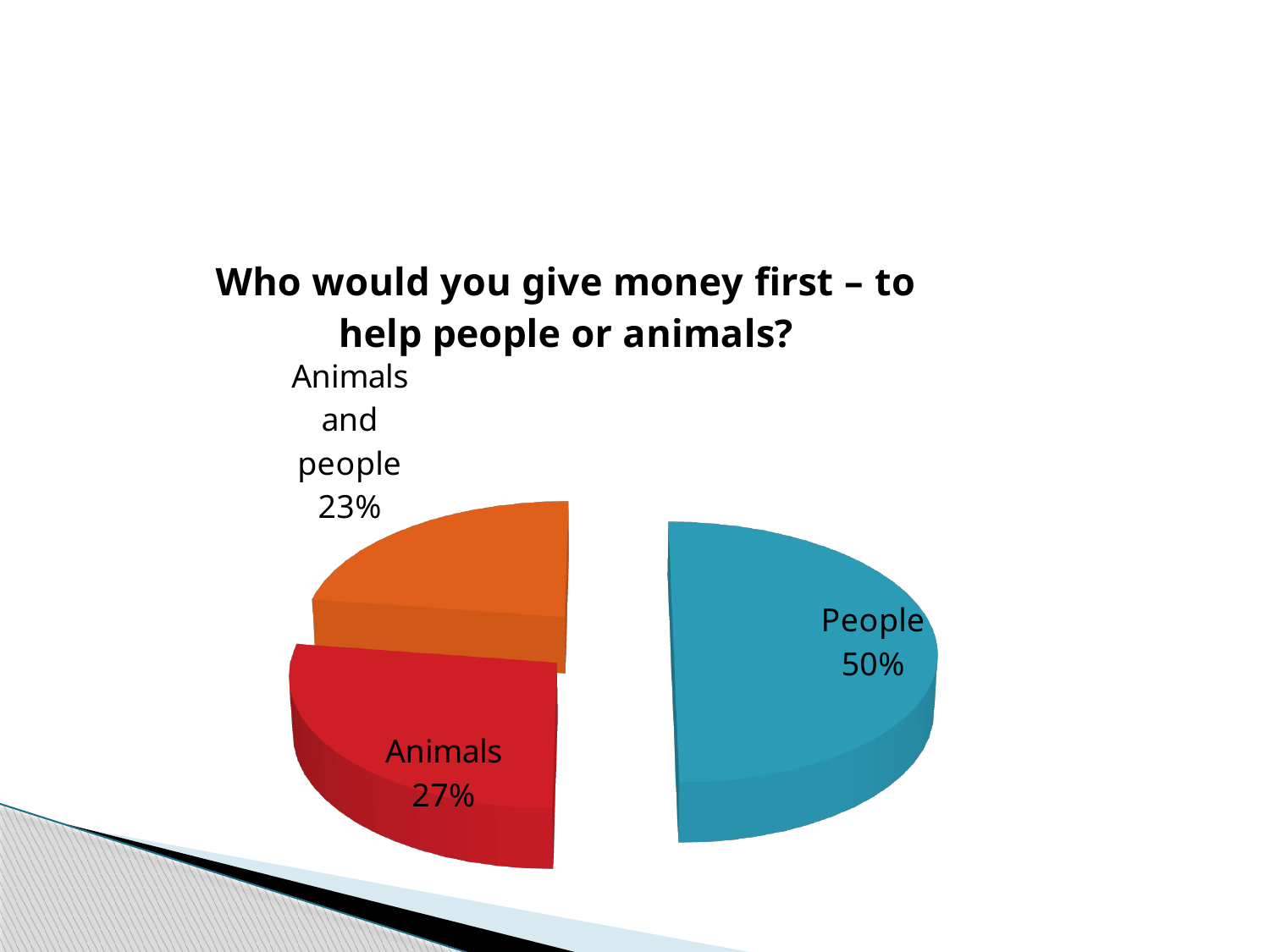
What colour is the People slice? Blue How many slices does the pie chart have? 3 Which is larger, the Animals slice or the Animals and people slice? Animals What kind of chart is shown on the slide? Pie chart What percentage of the pie is the Animals and people slice? 23% What percentage of the pie is the Animals slice? 27% What is the difference in percentage points between the People slice and the Animals slice? 23 Which slice is the smallest? Animals and people What percentage of the pie is the People slice? 50% Which slice is the largest? People What is the difference in percentage points between the Animals slice and the Animals and people slice? 4 What is the title of the chart? Who would you give money first – to help people or animals?